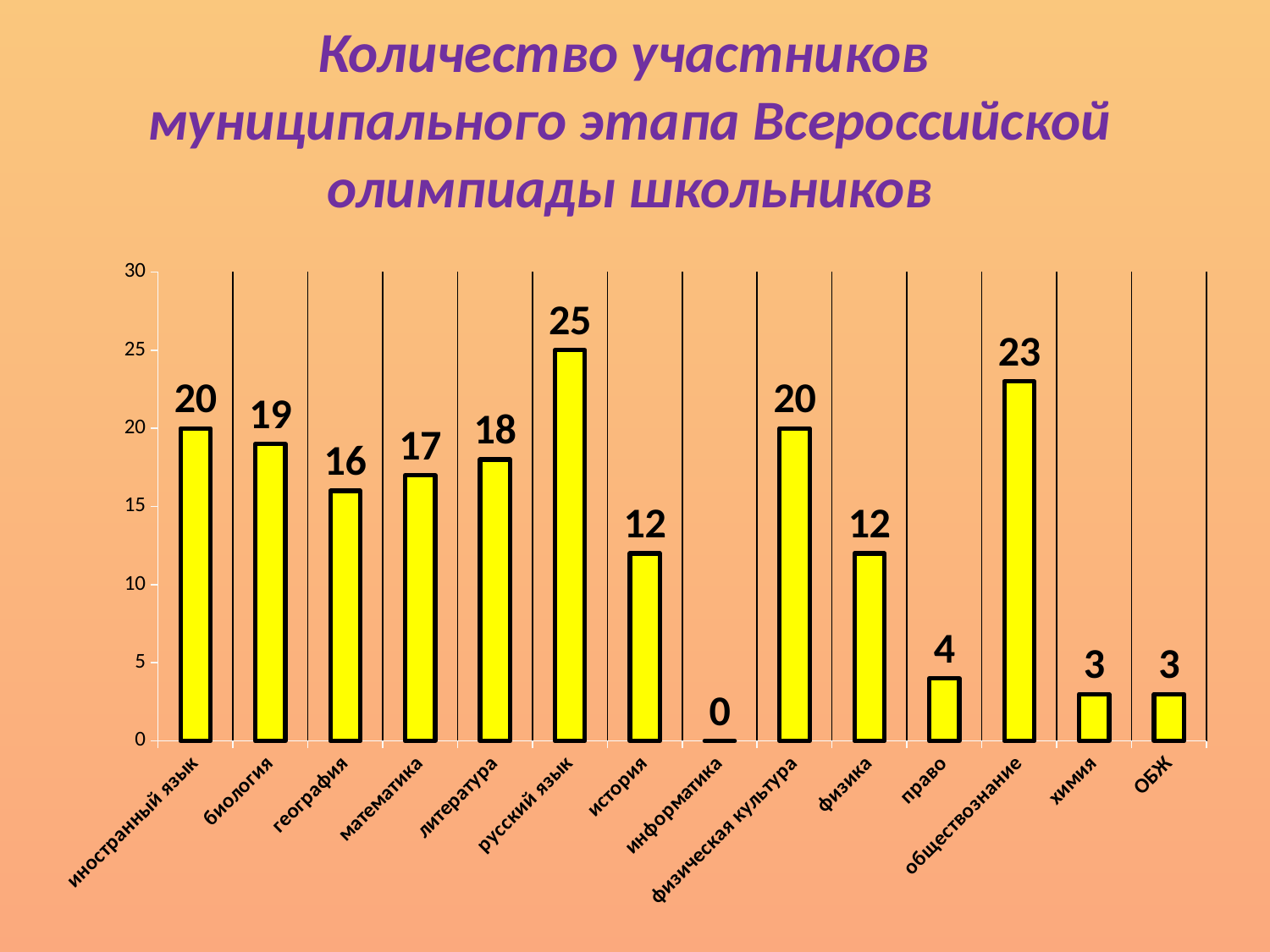
What is the value for информатика? 0 What is the difference between the values for русский язык and обществознание? 2 Which subject has the lowest number of participants? информатика What is the difference between the values for биология and право? 15 What is the value for обществознание? 23 Which is larger, the value for география or the value for литература? литература What kind of chart is shown on the slide? bar chart How many participants are shown for русский язык? 25 Is the value for физика greater or less than 15? less How many subjects (categories) are shown on the x axis? 14 Which subject has the highest number of participants? русский язык What colour are the bars in the chart? yellow